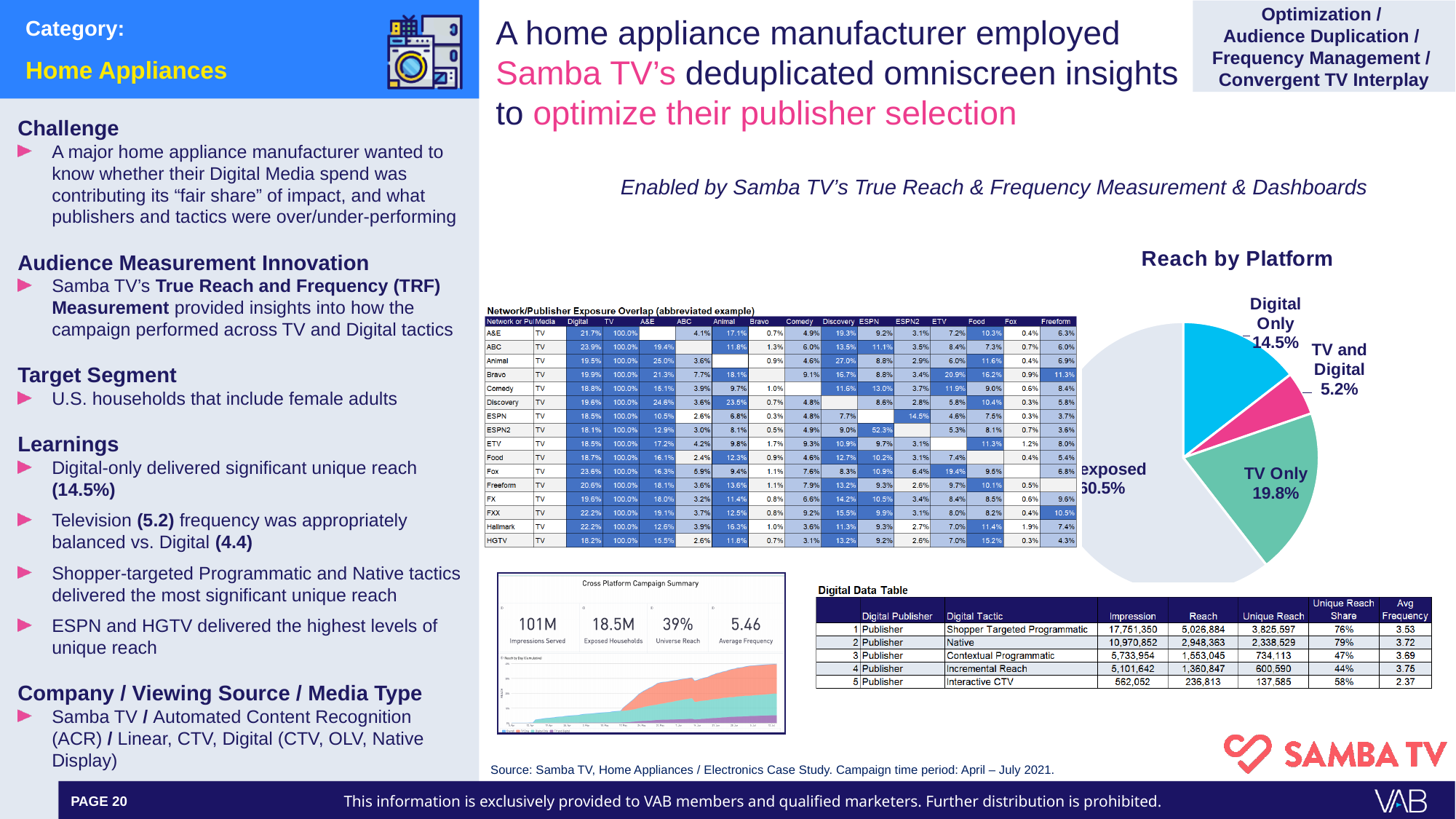
What is the title of the pie chart on the right side of the slide? Reach by Platform In the "Reach by Platform" pie chart, what is the value for Digital Only? 14.5% How many slices does the "Reach by Platform" pie chart have? 4 In the "Reach by Platform" pie chart, what colour is the TV and Digital slice? Pink In the "Reach by Platform" pie chart, what is the value for TV Only? 19.8% In the "Reach by Platform" pie chart, what is the value for TV and Digital? 5.2% In the "Reach by Platform" pie chart, what is the difference between TV Only and TV and Digital? 14.6% What kind of chart is the "Reach by Platform" chart? Pie chart In the "Reach by Platform" pie chart, what is the difference between TV Only and Digital Only? 5.3% In the "Reach by Platform" pie chart, which is the smallest slice? TV and Digital In the "Reach by Platform" pie chart, which is larger: TV Only or Digital Only? TV Only In the "Reach by Platform" pie chart, what is the difference between Digital Only and TV and Digital? 9.3%